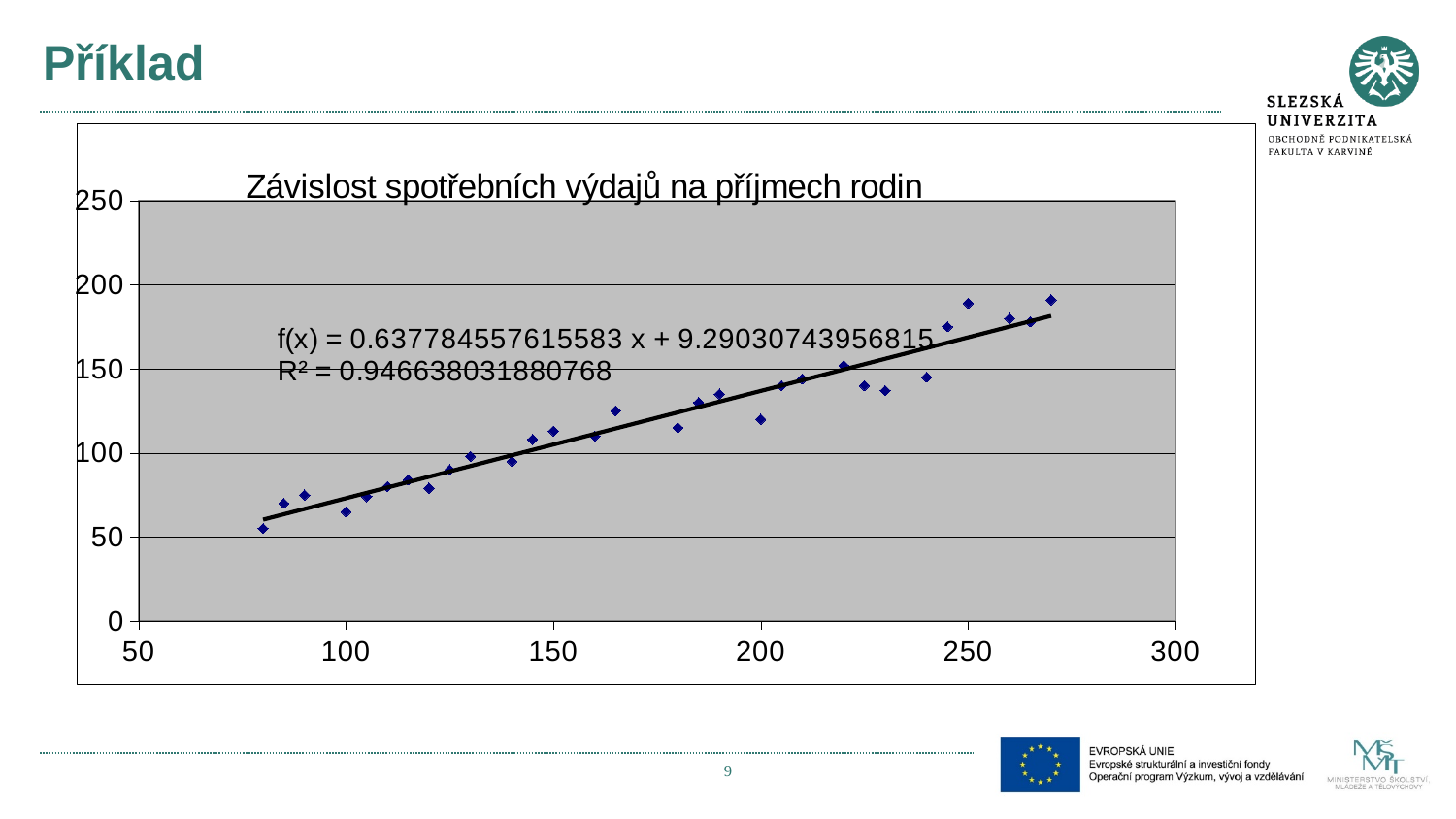
Is the value of the point at x = 200 greater or less than 150? less What is the title of the chart? Závislost spotřebních výdajů na příjmech rodin Do the plotted values generally rise or fall as the x value increases? rise What is the maximum value shown on the vertical axis? 250 Is the value of the leftmost point (at x of about 80) greater or less than 100? less Is the value of the point at x = 250 greater or less than 150? greater What is the slope of the fitted line f(x) shown on the chart? 0.637784557615583 What is the intercept of the fitted line f(x) shown on the chart? 9.29030743956815 What kind of chart is shown on the slide? scatter chart What is the R² value shown on the chart? 0.946638031880768